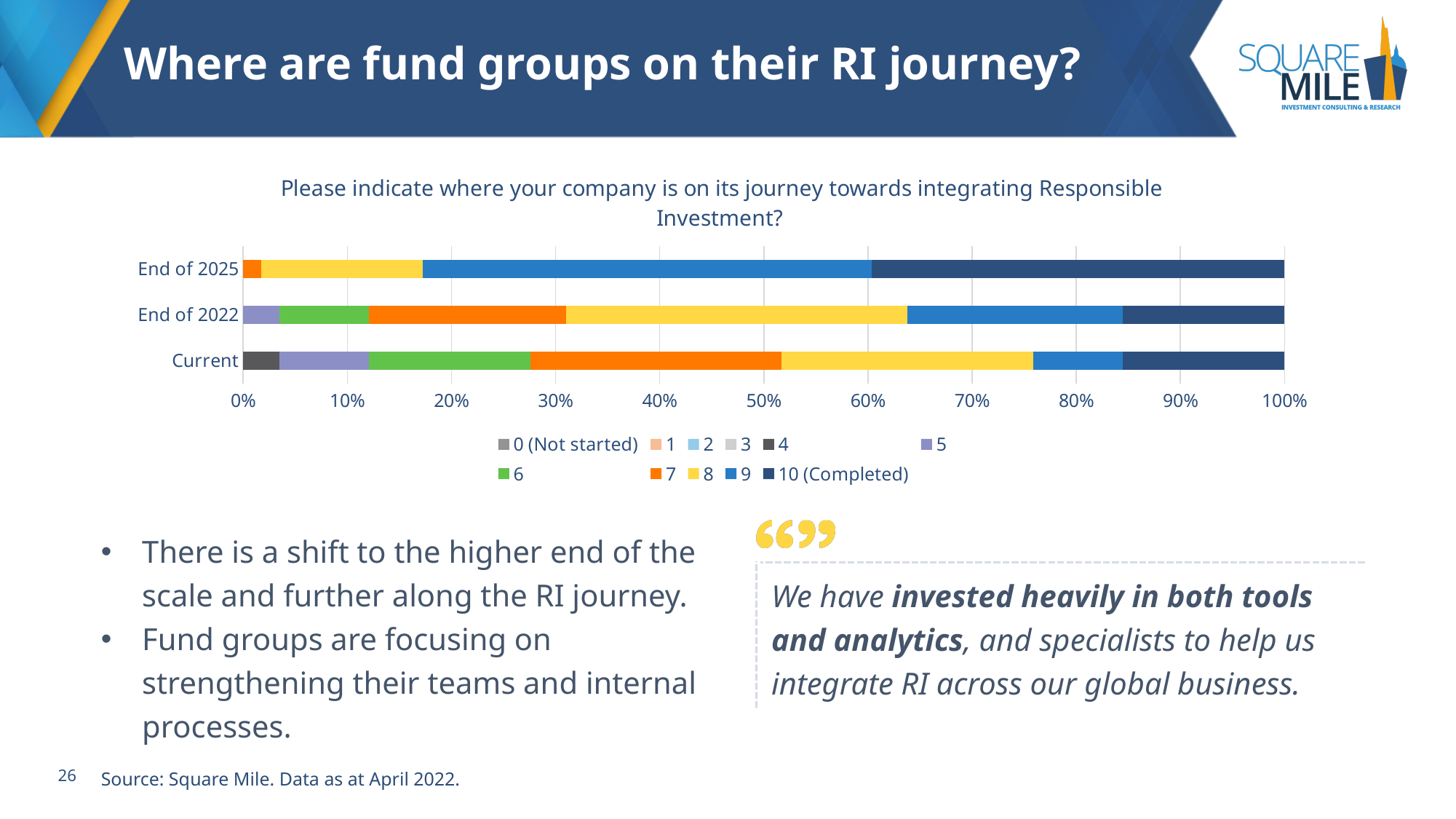
Which category has the largest segment for series 9? End of 2025 Is the share of series 10 (Completed) for Current greater or less than 30%? less Which category has the largest segment for series 10 (Completed)? End of 2025 Which has the larger segment for series 7: Current or End of 2025? Current What kind of chart is shown on the slide? Stacked bar chart Which category has the largest segment for series 8? End of 2022 What is the total of the Current stacked bar? 100% Is the share of series 9 for End of 2025 greater or less than 30%? greater How many series does the chart legend list? 11 How many categories (bars) are plotted on the chart? 3 What is the label of the last series in the legend? 10 (Completed)